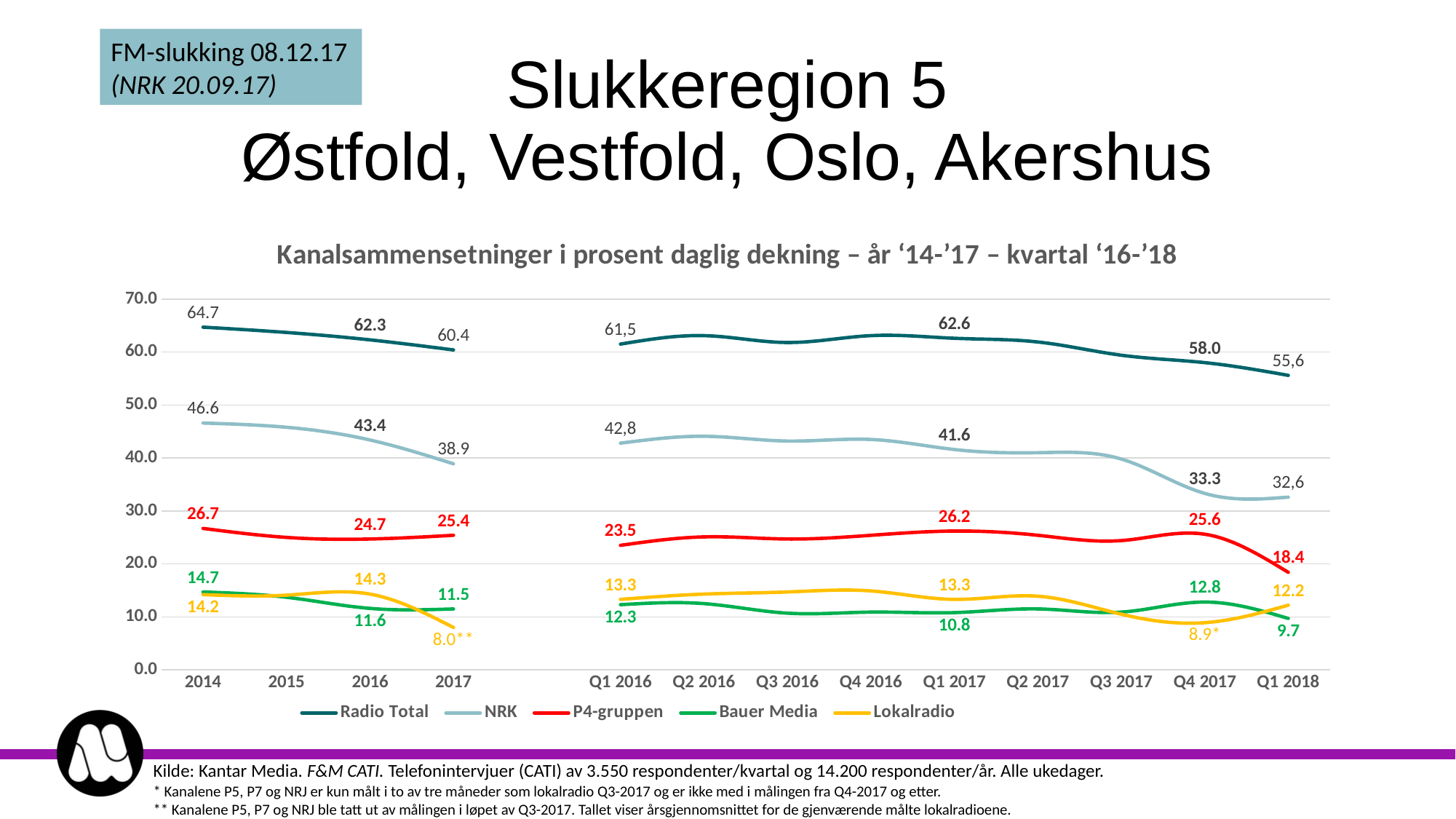
What is the value for NRK in Q1 2018? 32,6 How many series does the legend list? 5 Which is larger in 2017: the value for Bauer Media or the value for Lokalradio? Bauer Media What is the difference between the Radio Total values for 2014 and 2017? 4.3 Which series has the highest value in Q1 2018? Radio Total What is the value for P4-gruppen in Q1 2017? 26.2 What kind of chart is shown on the slide? Line chart Which series has the lowest value in Q1 2018? Bauer Media What is the value for Lokalradio in 2016? 14.3 What is the value for Radio Total in 2014? 64.7 What is the value for Bauer Media in Q4 2017? 12.8 Does the NRK line rise or fall from Q1 2017 to Q1 2018? Fall